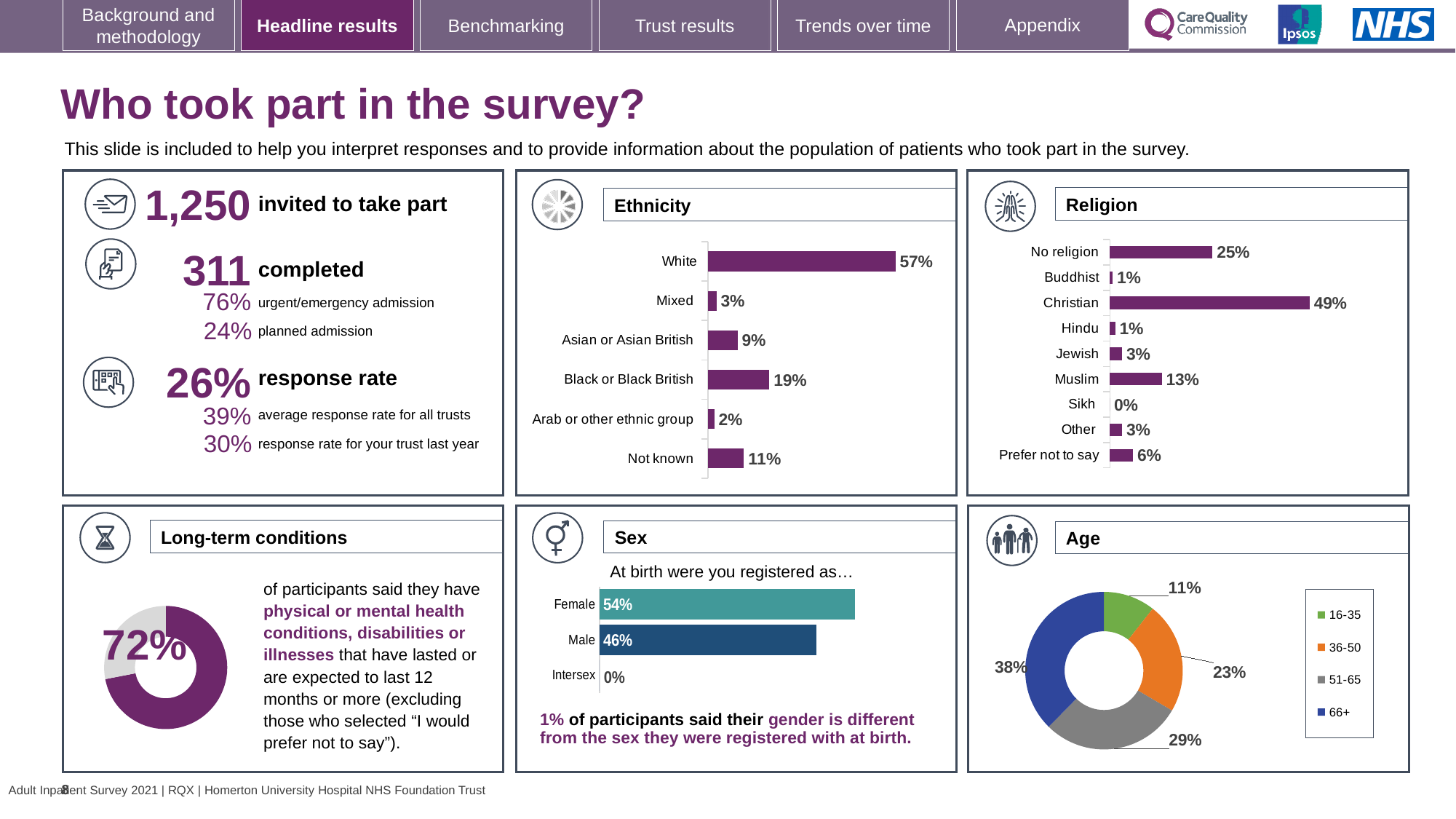
How many categories are shown in the Religion chart? 9 In the Sex chart, what percentage of participants were registered as Female at birth? 54% In the Religion chart, what is the value for Muslim? 13% In the Ethnicity chart, what percentage of participants were White? 57% In the Religion chart, which is larger, the value for No religion or the value for Prefer not to say? No religion In the Sex chart, what is the difference between the Female and Male values? 8% How many categories are shown in the Ethnicity chart? 6 In the Religion chart, which category has the highest value? Christian In the Ethnicity chart, which category has the lowest value? Arab or other ethnic group In the Ethnicity chart, what is the difference between the values for Black or Black British and Asian or Asian British? 10% What kind of chart is the Age chart? Doughnut chart In the Age chart, what share of participants were aged 66+? 38%